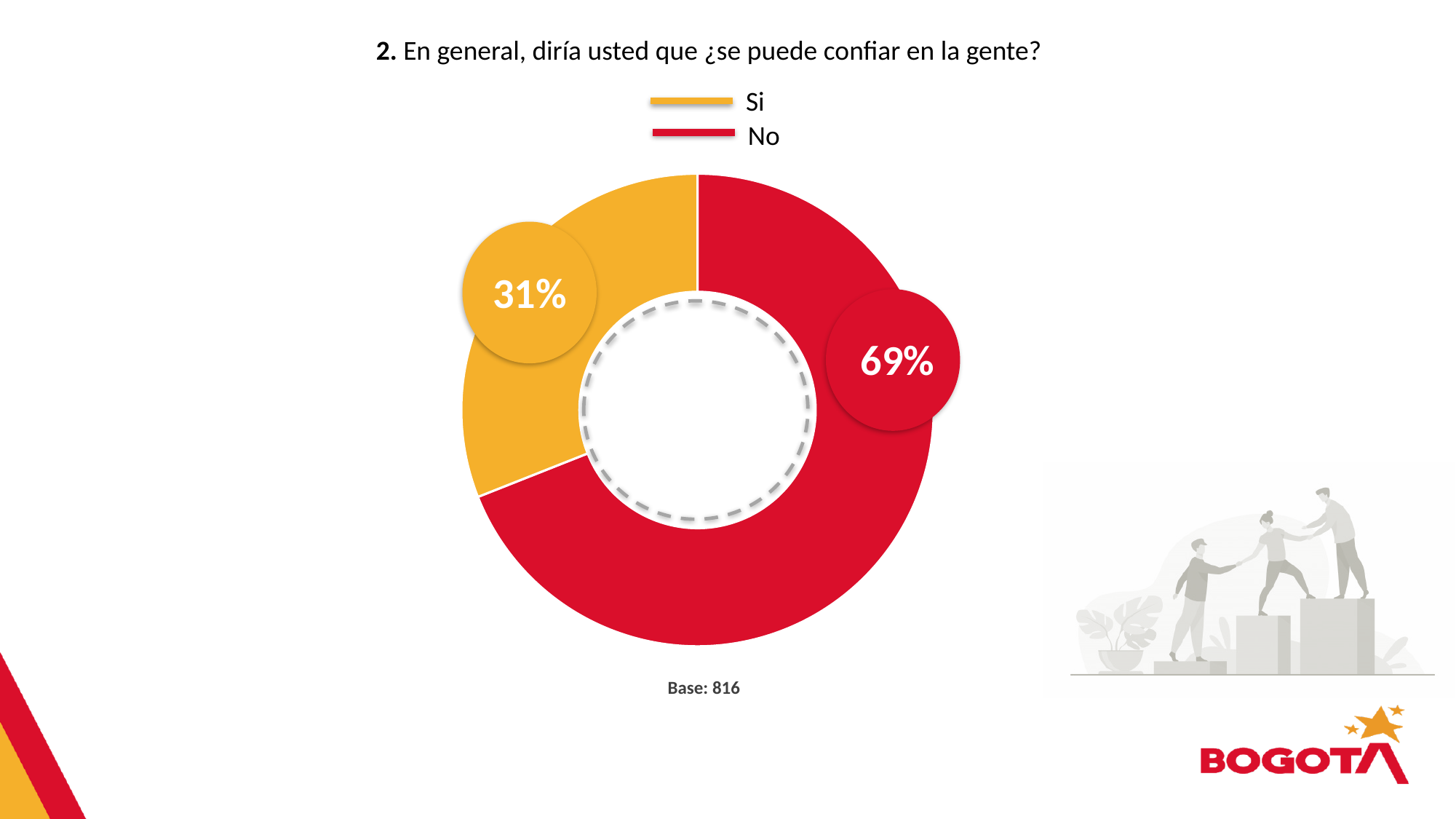
What share of the pie does the "No" slice represent? 69% What is the base (number of respondents) shown below the chart? 816 What kind of chart is shown on the slide? Pie chart (doughnut) What percentage of respondents answered "Si"? 31% Which response has the largest share of the chart? No How many entries does the legend list? 2 What colour represents the "Si" response in the chart? Orange/yellow What percentage of respondents answered "No"? 69% What is the difference in percentage points between the "No" and "Si" responses? 38 How many categories are shown in the chart? 2 Which is larger, the share for "Si" or the share for "No"? No Which response has the smallest share of the chart? Si